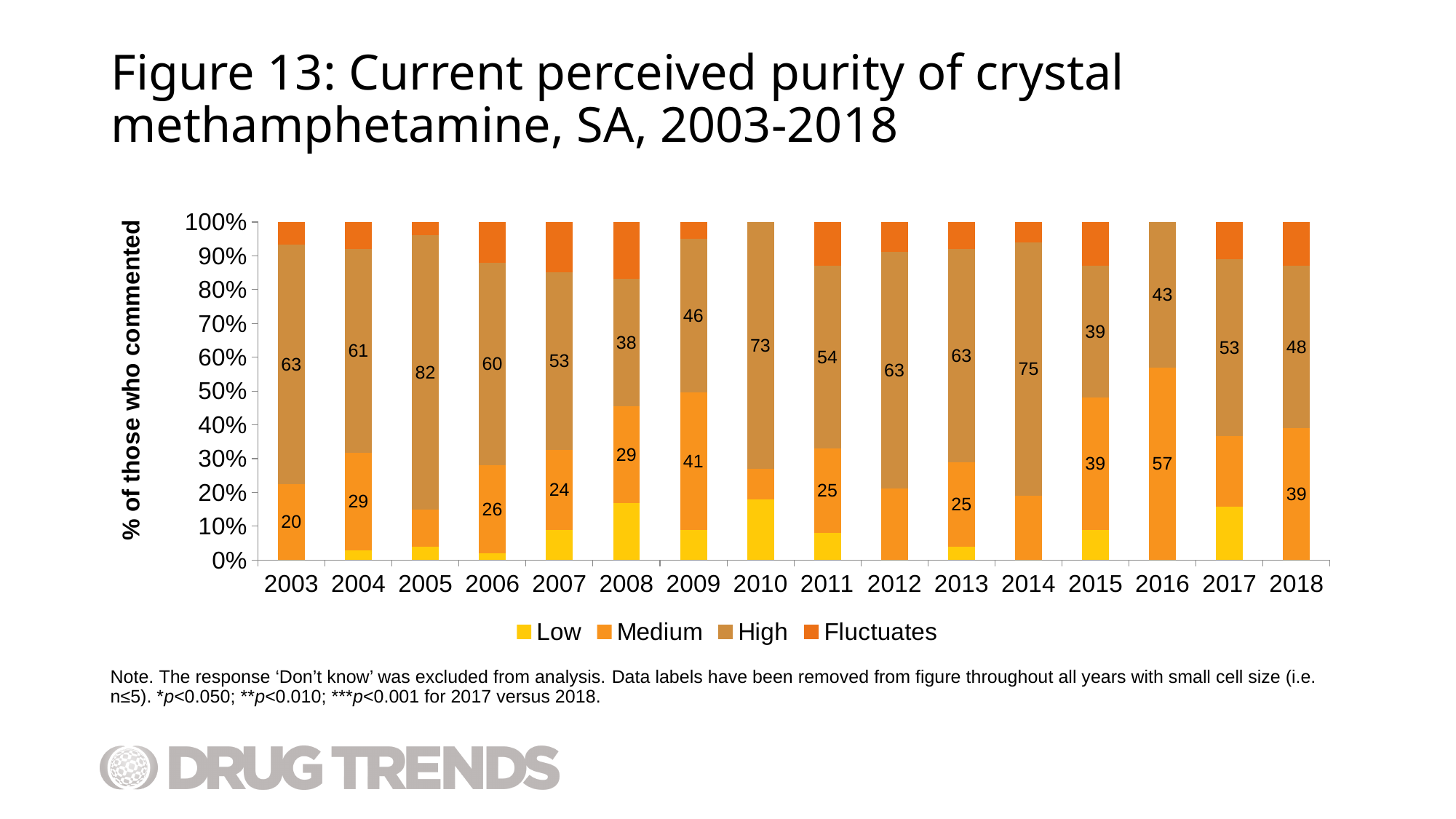
In which year is the High series at its highest? 2005 What is the value of the High series for 2005? 82 In which year is the Medium series at its highest? 2016 What kind of chart is shown on the slide? Stacked bar chart How many years are shown on the x axis? 16 What is the value of the Medium series for 2016? 57 What is the difference between the High value for 2003 and the High value for 2008? 25 What is the value of the High series for 2018? 48 What is the difference between the Medium value for 2016 and the Medium value for 2018? 18 Is the Low value for 2008 greater or less than 10%? greater Which year has the larger Medium value, 2009 or 2011? 2009 How many series does the legend list? 4